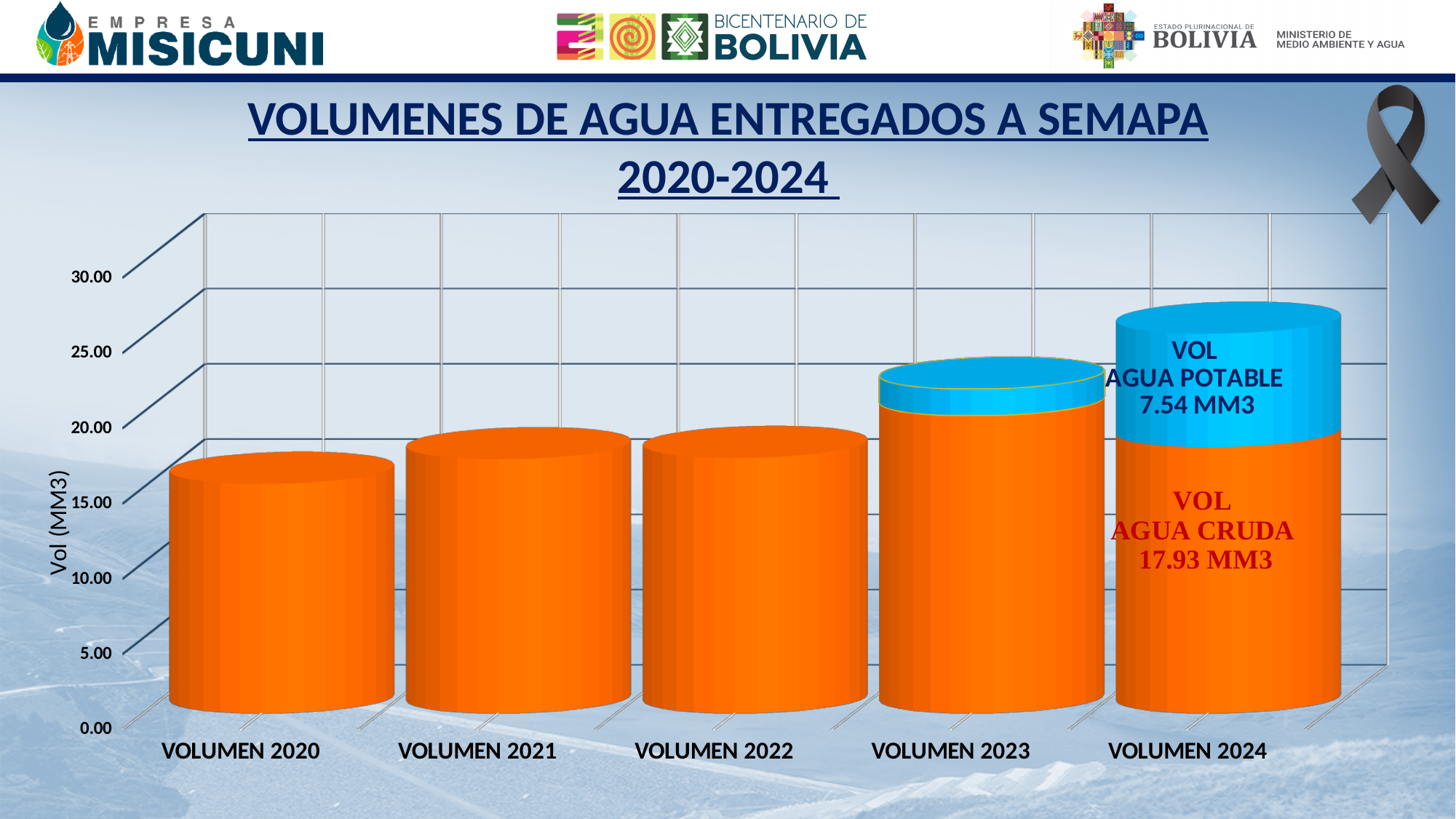
Which year has the lowest total volume? VOLUMEN 2020 What is the volume of agua potable labelled for VOLUMEN 2024? 7.54 MM3 Is the total volume for VOLUMEN 2020 greater or less than 20.00? less Which year has the highest total volume? VOLUMEN 2024 What is the total volume (agua cruda plus agua potable) for VOLUMEN 2024? 25.47 MM3 What is the title of the chart? VOLUMENES DE AGUA ENTREGADOS A SEMAPA 2020-2024 What type of chart is shown on the slide? Bar chart Is the total volume for VOLUMEN 2023 greater or less than 20.00? greater How much larger is the agua cruda volume than the agua potable volume in VOLUMEN 2024? 10.39 MM3 What is the volume of agua cruda labelled for VOLUMEN 2024? 17.93 MM3 How many categories (years) are plotted on the x axis? 5 Which is larger, the total volume for VOLUMEN 2022 or VOLUMEN 2023? VOLUMEN 2023